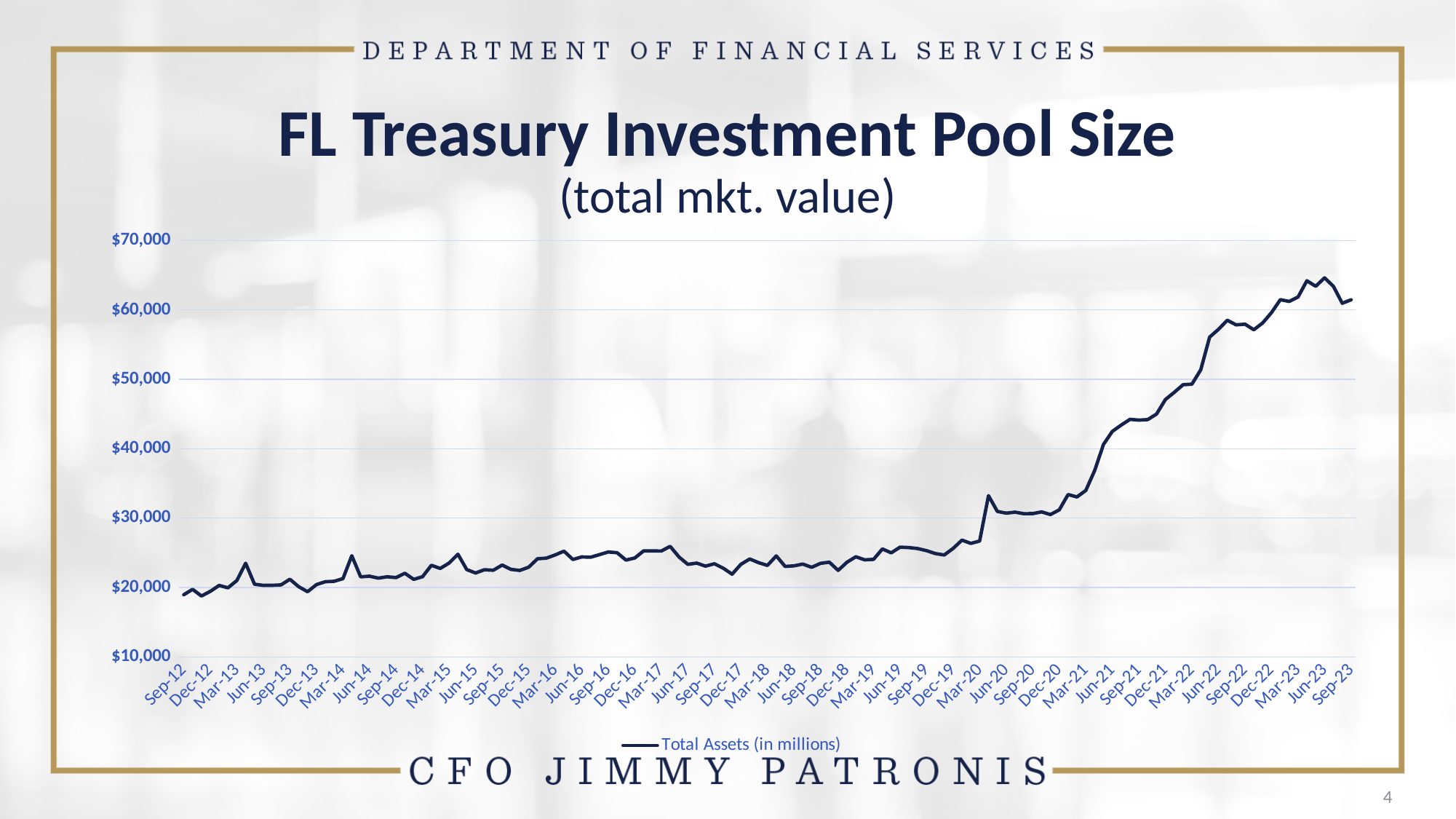
Overall, do the values rise or fall from Sep-12 to Sep-23? rise Is the value for Jun-21 greater or less than $40,000? greater Which is larger, the value for Jun-19 or the value for Jun-21? Jun-21 What is the name of the series shown in the legend? Total Assets (in millions) Is the value for Sep-12 greater or less than $20,000? less What is the title of the chart? FL Treasury Investment Pool Size (total mkt. value) How many series does the legend list? 1 Is the value for Sep-23 greater or less than $60,000? greater Which is larger, the value for Sep-12 or the value for Sep-23? Sep-23 What kind of chart is shown on the slide? line chart